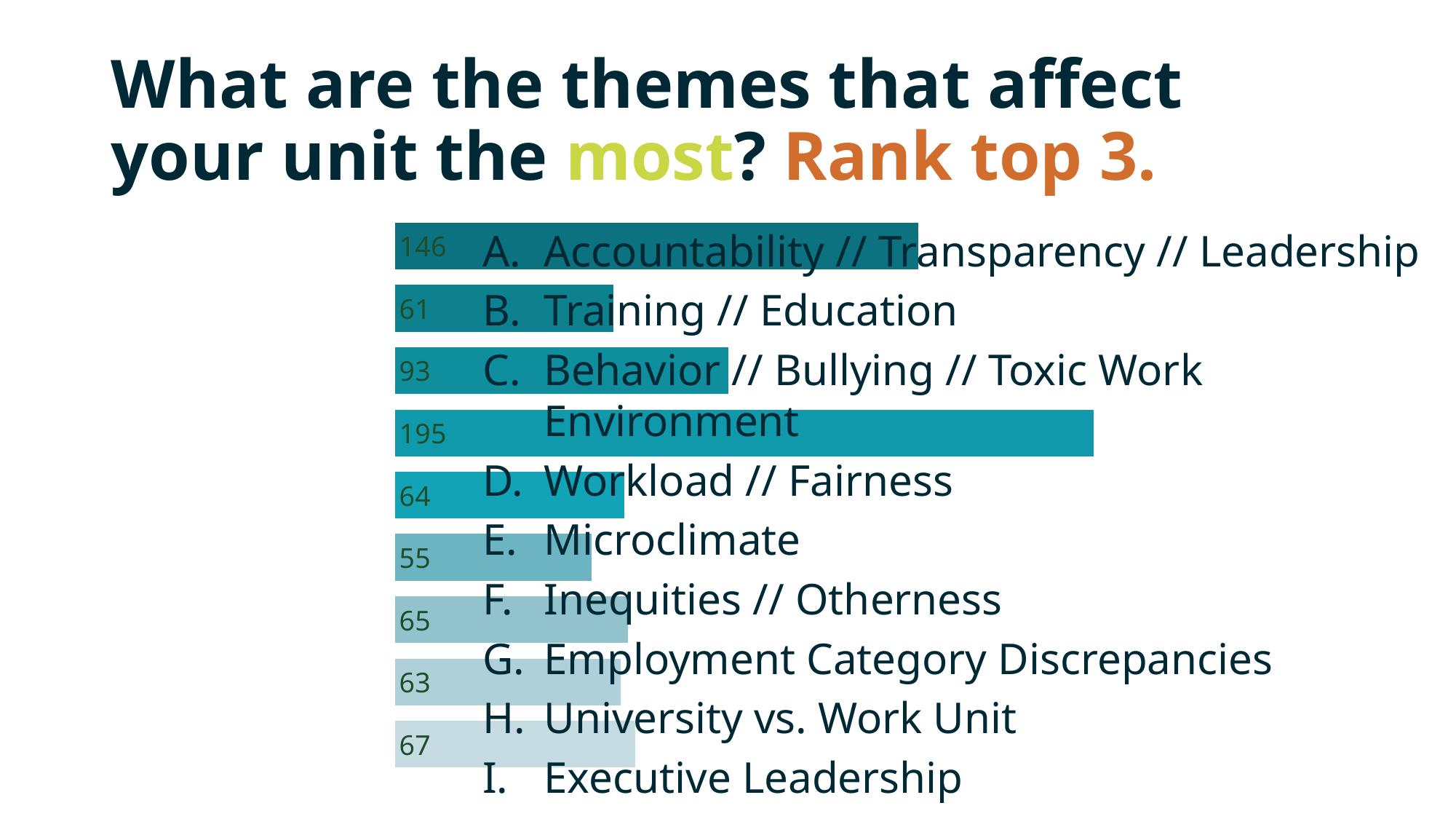
What kind of chart is shown on the slide? bar chart What is the value shown on the bottom bar? 67 What is the highest value shown on any bar in the chart? 195 What is the value shown on the second bar, labelled B. Training // Education? 61 How many bars are plotted in the chart? 9 What is the value shown on the fourth bar from the top? 195 What is the value shown on the third bar, labelled C. Behavior // Bullying // Toxic Work Environment? 93 What is the lowest value shown on any bar in the chart? 55 What is the difference between the values on the second bar (61) and the third bar (93)? 32 Which is larger: the value on the top bar (A) or the value on the third bar (C)? A (146) What is the value shown on the top bar, labelled A. Accountability // Transparency // Leadership? 146 What is the difference between the largest bar value (195) and the top bar value (146)? 49